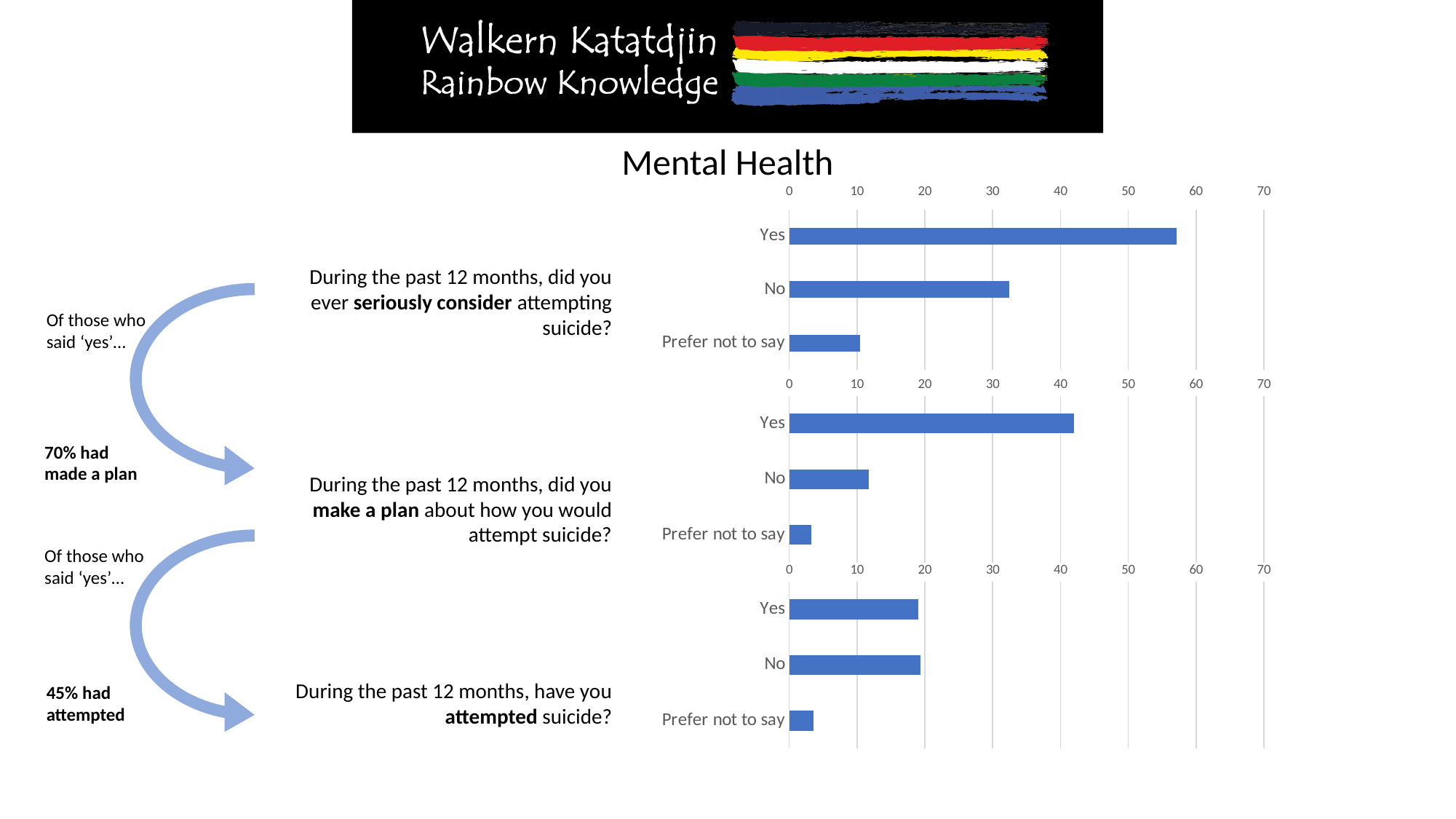
In the chart for 'During the past 12 months, did you ever seriously consider attempting suicide?', is the value for No greater or less than 40? less In the chart for 'During the past 12 months, did you ever seriously consider attempting suicide?', which category has the lowest value? Prefer not to say In the chart for 'During the past 12 months, did you ever seriously consider attempting suicide?', which category has the highest value? Yes In the chart for 'During the past 12 months, have you attempted suicide?', is the value for Yes greater or less than 30? less In the chart for 'During the past 12 months, did you ever seriously consider attempting suicide?', is the value for Yes greater or less than 50? greater In the chart for 'During the past 12 months, have you attempted suicide?', which category has the lowest value? Prefer not to say What kind of chart is used for 'During the past 12 months, did you ever seriously consider attempting suicide?'? Bar chart In the chart for 'During the past 12 months, did you make a plan about how you would attempt suicide?', which category has the highest value? Yes How many categories does the chart for 'During the past 12 months, have you attempted suicide?' show? 3 In the chart for 'During the past 12 months, did you make a plan about how you would attempt suicide?', which is larger, the value for No or the value for Prefer not to say? No